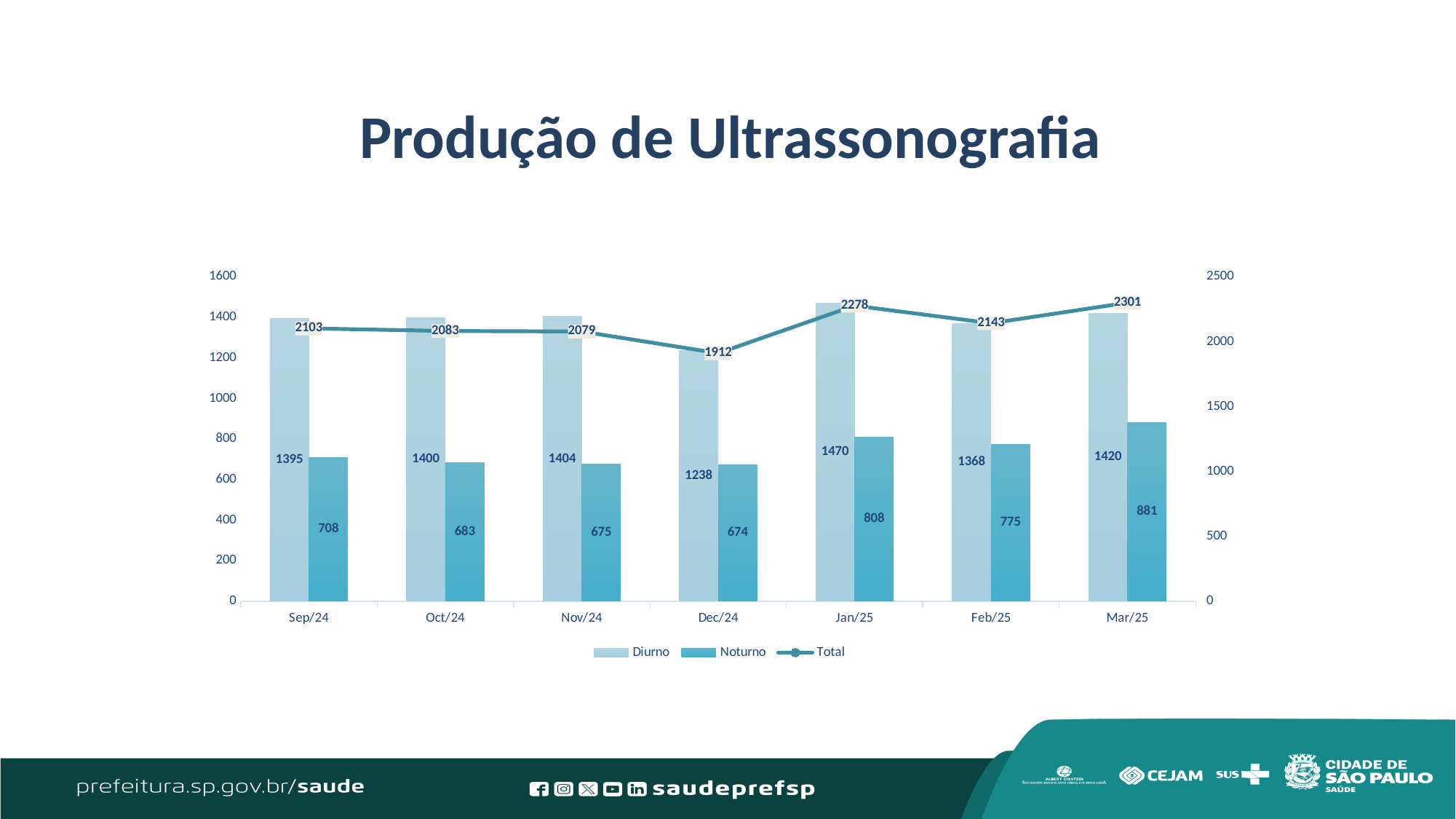
Which month has the lowest Total value? Dec/24 What is the Diurno value for Jan/25? 1470 How many series does the legend list? 3 What is the difference between the Diurno and Noturno values for Sep/24? 687 How many months are shown on the x axis? 7 What is the Total value for Mar/25? 2301 Does the Total line rise or fall from Dec/24 to Jan/25? Rise Which month has the highest Noturno value? Mar/25 What kind of chart is used for the Diurno and Noturno series? Bar chart What is the title of the chart? Produção de Ultrassonografia What is the Noturno value for Dec/24? 674 Which is larger, the Noturno value for Jan/25 or the Noturno value for Feb/25? Jan/25